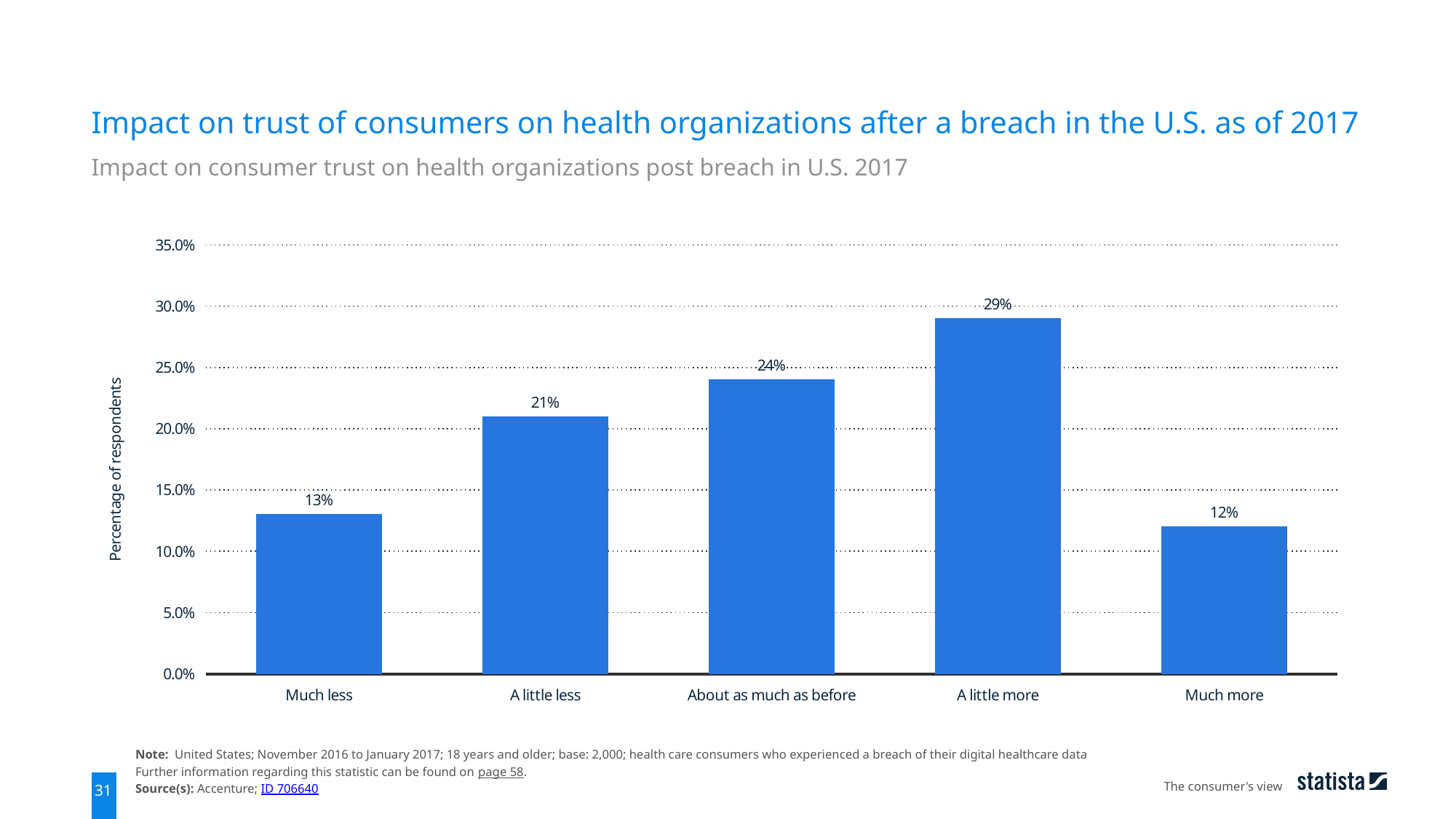
How many categories are shown on the x axis? 5 What is the value for "Much less"? 13% Which category has the lowest percentage of respondents? Much more What percentage of respondents answered "About as much as before"? 24% What is the label of the y axis? Percentage of respondents What kind of chart is shown on the slide? Bar chart What percentage of respondents said they trust health organizations "A little more" after a breach? 29% What is the source of the data shown in the chart? Accenture Which category has the highest percentage of respondents? A little more Is the value for "A little less" greater or less than 20.0%? greater Which is larger, the value for "A little less" or the value for "About as much as before"? About as much as before What is the difference between the values for "A little more" and "Much more"? 17%